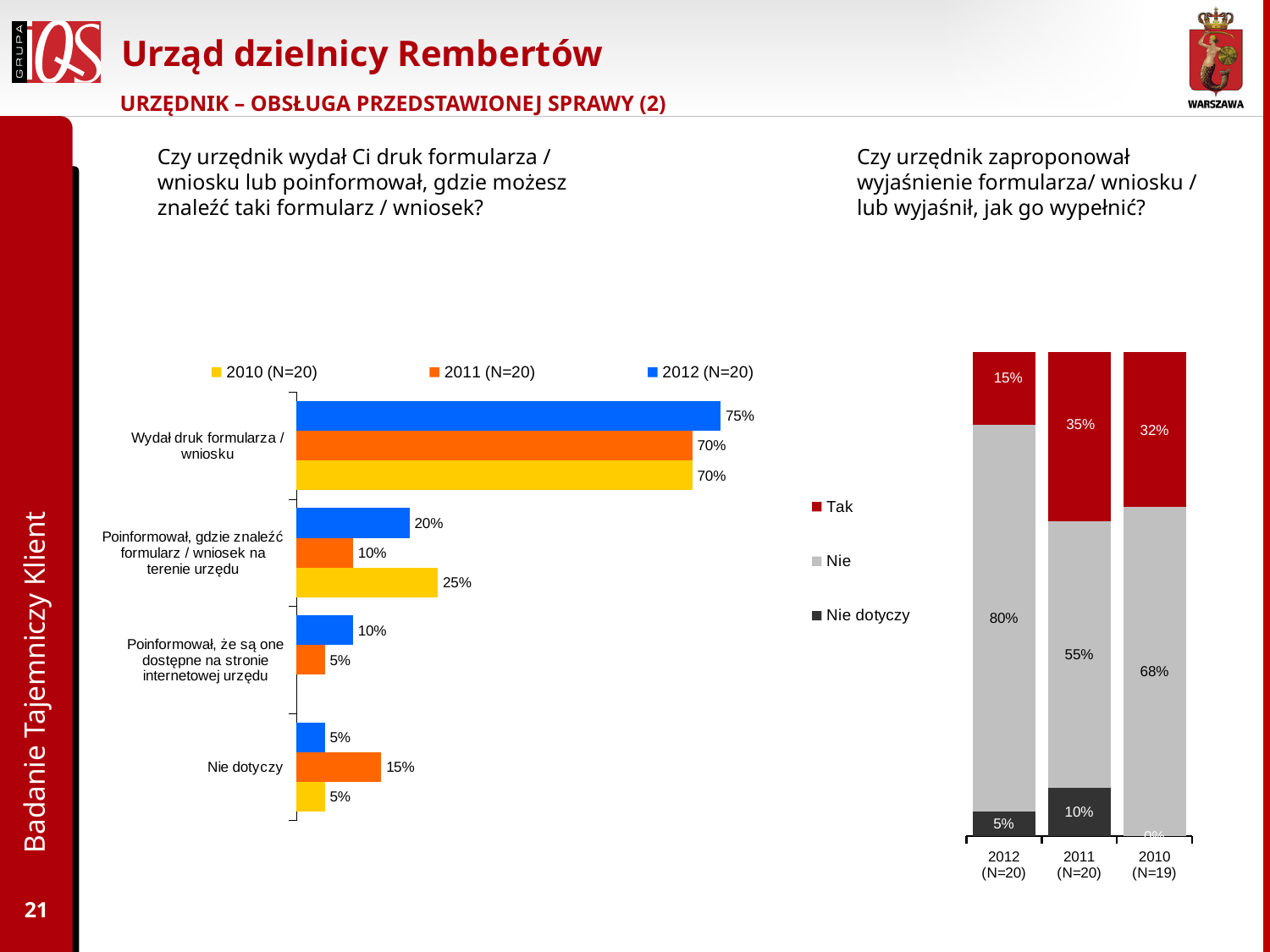
In the left chart, what is the 2012 value for 'Wydał druk formularza / wniosku'? 75% In the left chart, what is the 2010 value for 'Poinformował, gdzie znaleźć formularz / wniosek na terenie urzędu'? 25% In the left chart, what is the 2011 value for 'Nie dotyczy'? 15% In the left chart, what is the difference between the 2012 and 2011 values for 'Wydał druk formularza / wniosku'? 5% What type of chart is the left chart? Bar chart In the right stacked chart, what is the total of the 2012 (N=20) bar? 100% In the right stacked chart, what is the 'Tak' value for 2011 (N=20)? 35% In the left chart, how many series does the legend list? 3 In the right stacked chart, is the 'Nie' value larger for 2012 or for 2010? 2012 In the left chart, which category has the highest 2012 value? Wydał druk formularza / wniosku In the right stacked chart, what is the 'Nie' value for 2012 (N=20)? 80% In the right stacked chart, which year has the highest 'Tak' value? 2011 (N=20)